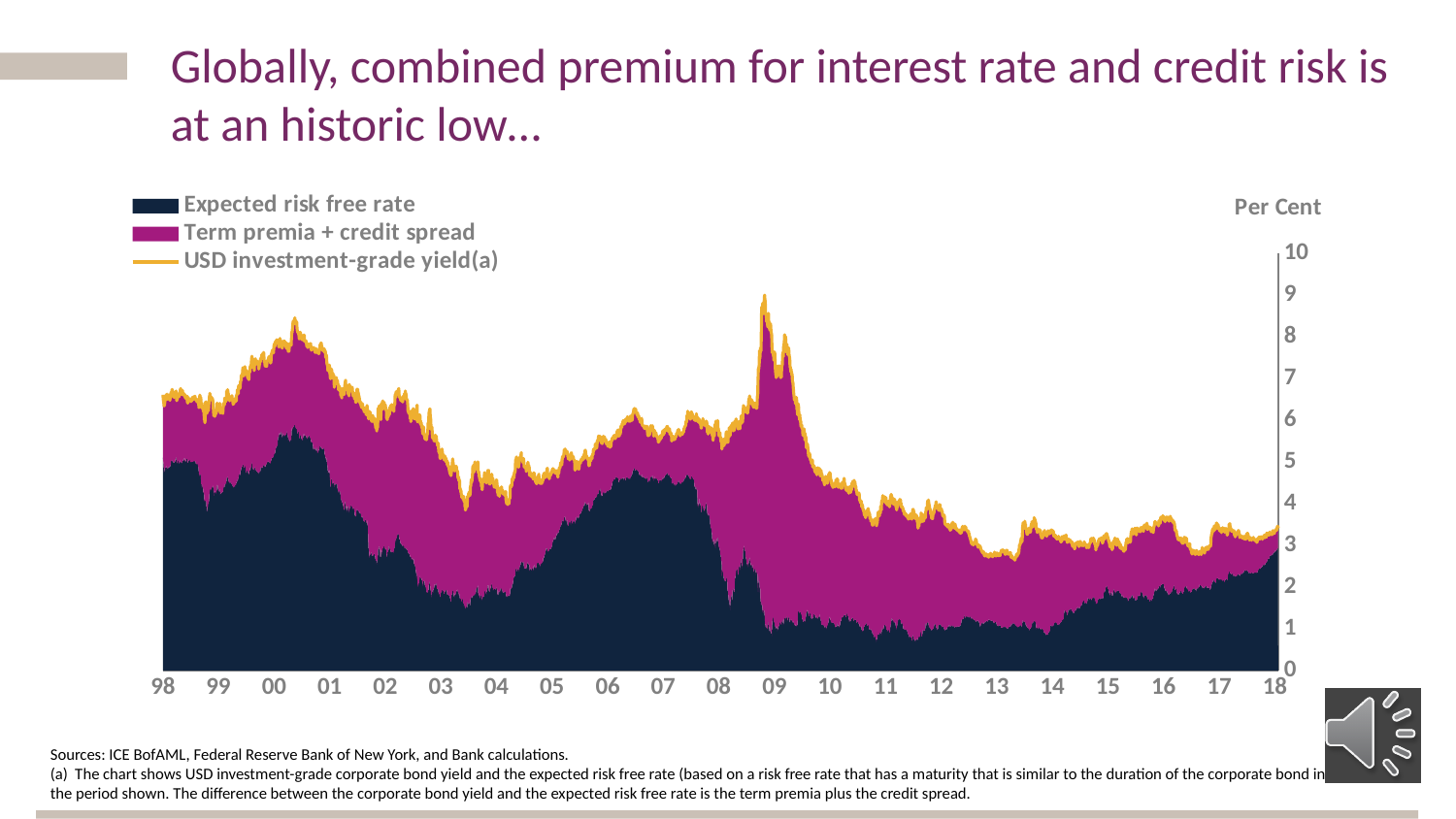
What is the unit label shown above the vertical axis? Per Cent Is the USD investment-grade yield at the start of the series (98) greater or less than 5? greater Is the expected risk free rate in 98 greater or less than 4? greater How many year labels are shown on the x axis? 21 What kind of chart is shown on the slide? Stacked area chart with a line overlay Is the USD investment-grade yield at the end of the series (18) greater or less than 4? less Does the USD investment-grade yield rise or fall between 09 and 13? fall How many series does the legend list? 3 Which legend entry is drawn as a line rather than a filled area? USD investment-grade yield(a) Which is larger, the USD investment-grade yield in 98 or in 18? 98